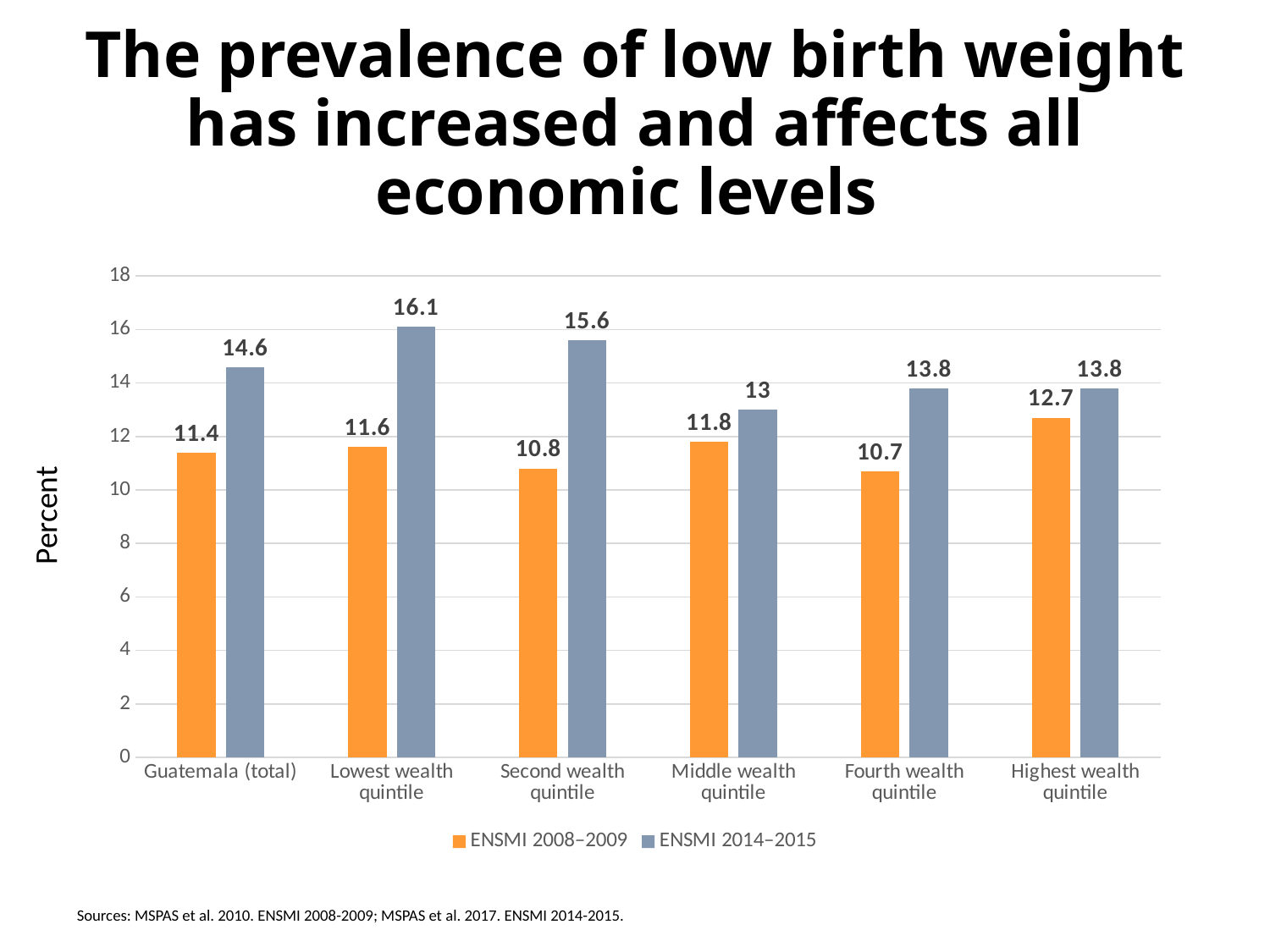
How many categories are shown on the x axis? 6 Which colour represents the ENSMI 2008–2009 series? Orange Is the ENSMI 2014–2015 value for the Middle wealth quintile greater or less than 12? greater What is the label of the y axis? Percent What is the difference between the ENSMI 2014–2015 and ENSMI 2008–2009 values for the Second wealth quintile? 4.8 Which is larger for the Highest wealth quintile: the ENSMI 2008–2009 value or the ENSMI 2014–2015 value? ENSMI 2014–2015 What is the value for the Fourth wealth quintile in the ENSMI 2008–2009 series? 10.7 How many series does the legend list? 2 What is the value for Guatemala (total) in the ENSMI 2014–2015 series? 14.6 What kind of chart is shown on the slide? Bar chart Which category has the highest value in the ENSMI 2014–2015 series? Lowest wealth quintile Which category has the lowest value in the ENSMI 2008–2009 series? Fourth wealth quintile